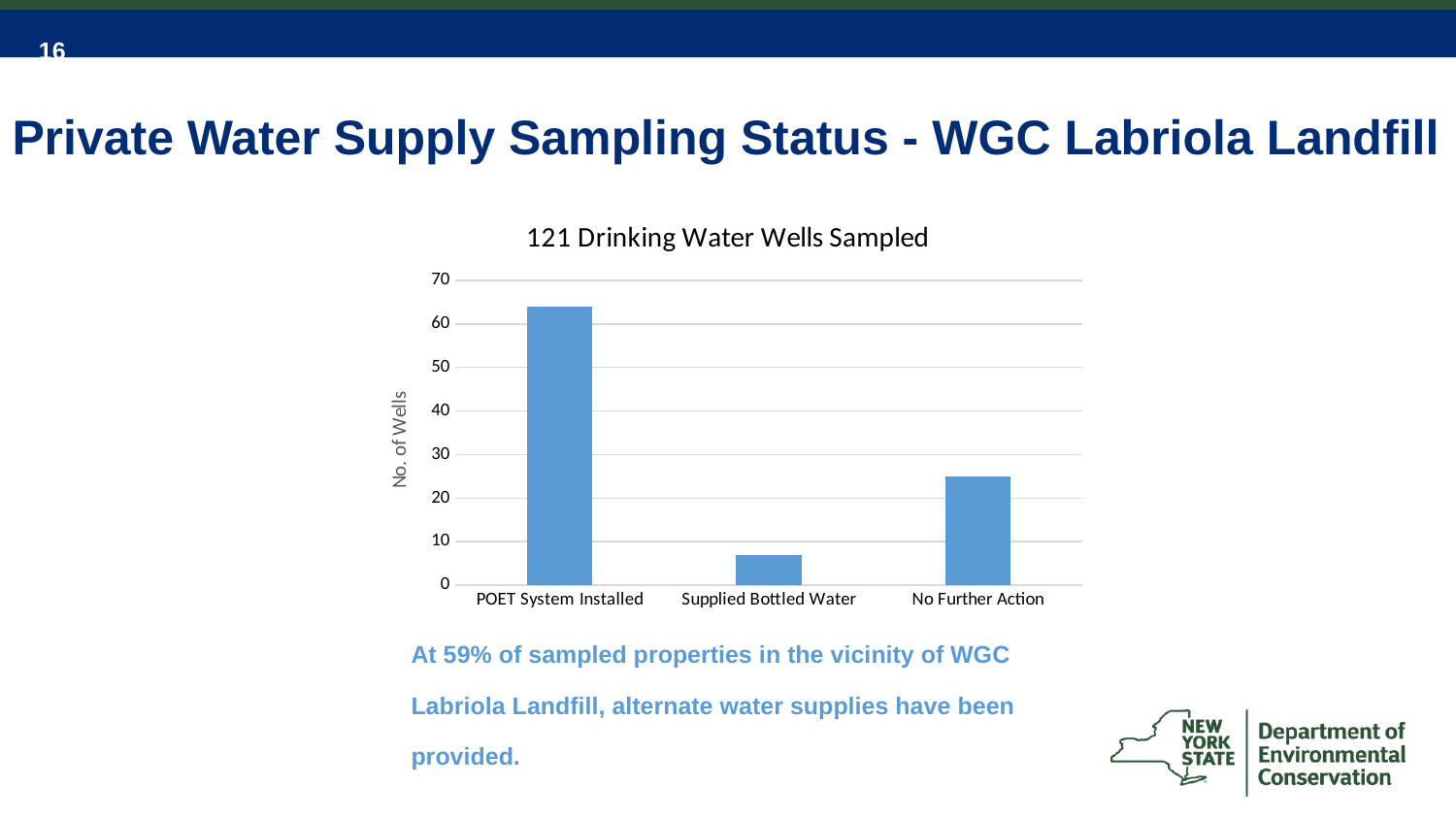
What is the label on the y axis of the chart? No. of Wells Which category has the highest number of wells? POET System Installed What kind of chart is shown on the slide? bar chart Which is larger, the value for POET System Installed or the value for No Further Action? POET System Installed How many categories are shown on the x axis of the chart? 3 Is the value for POET System Installed greater or less than 60? greater Which is larger, the value for No Further Action or the value for Supplied Bottled Water? No Further Action Which category has the lowest number of wells? Supplied Bottled Water What is the title of the chart? 121 Drinking Water Wells Sampled Is the value for No Further Action greater or less than 20? greater Is the value for Supplied Bottled Water greater or less than 10? less